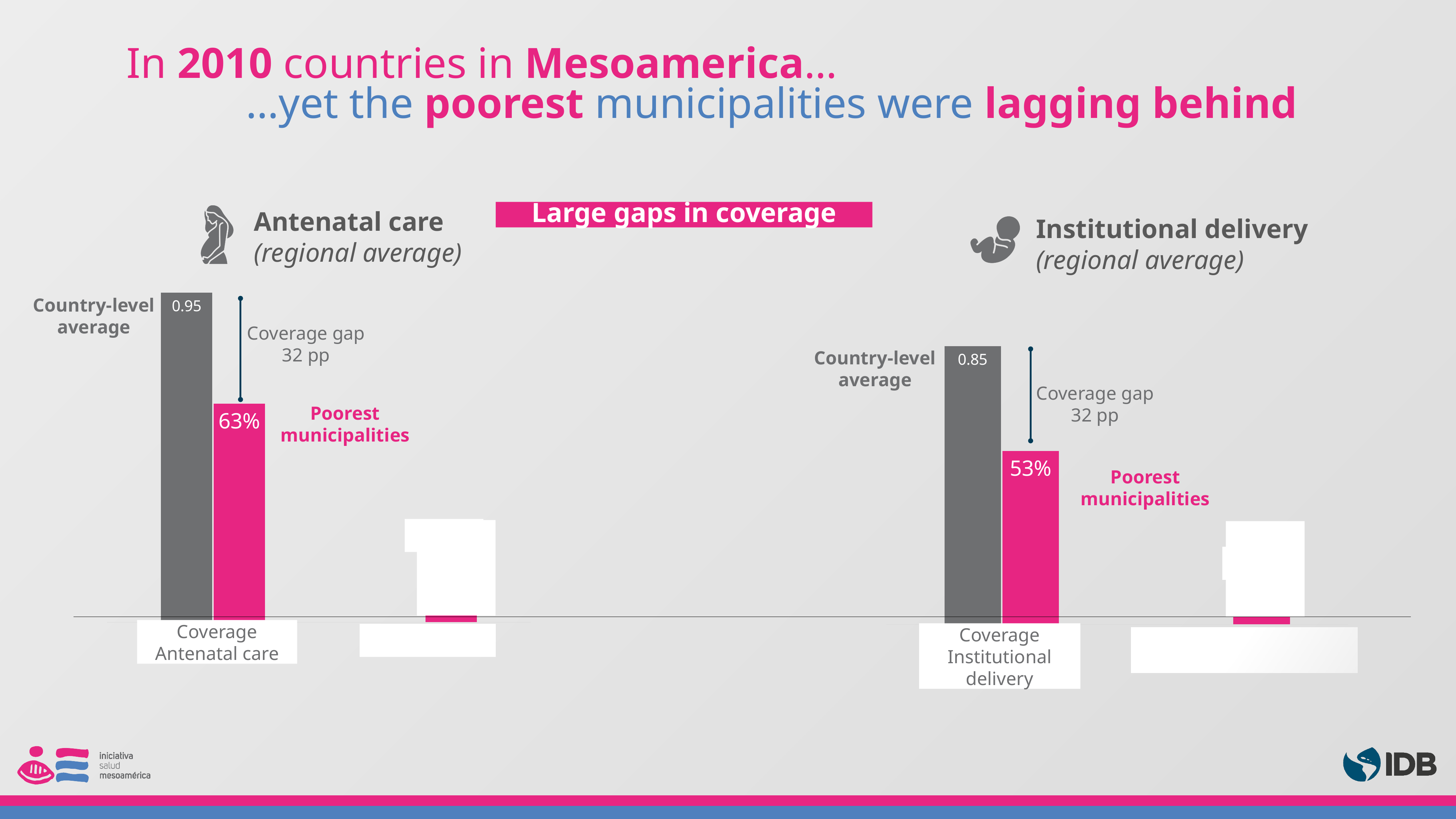
In the Antenatal care chart, what colour is the Poorest municipalities bar? Pink In the Antenatal care chart, what is the coverage gap between the Country-level average and the Poorest municipalities? 32 pp In the Institutional delivery chart, which bar is the lowest? Poorest municipalities In the Institutional delivery chart, what is the coverage gap between the Country-level average and the Poorest municipalities? 32 pp In the Antenatal care chart, which bar is higher: Country-level average or Poorest municipalities? Country-level average In the Antenatal care chart, what is the value for the Country-level average? 0.95 In the Antenatal care chart, what is the value for the Poorest municipalities? 63% What kind of chart is the Antenatal care chart? Bar chart How many bars are plotted in the Institutional delivery chart? 2 Which is larger: the Poorest municipalities value in the Antenatal care chart or the Poorest municipalities value in the Institutional delivery chart? Antenatal care In the Institutional delivery chart, what is the value for the Poorest municipalities? 53% In the Institutional delivery chart, what is the value for the Country-level average? 0.85